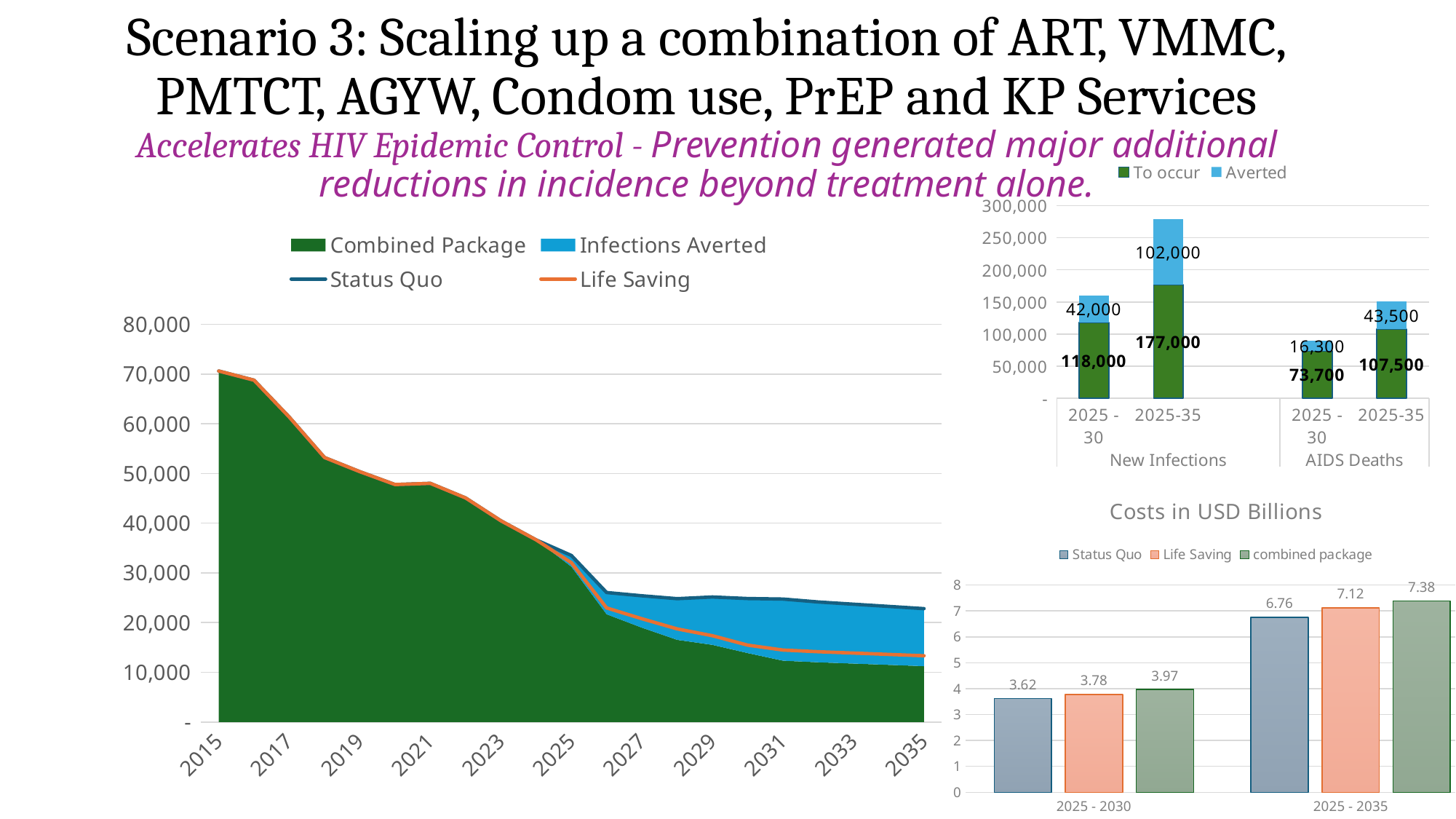
In the large chart on the left, is the Status Quo value in 2035 greater or less than 20,000? greater In the 'Costs in USD Billions' chart, what is the difference between the combined package and Status Quo values in 2025 - 2030? 0.35 In the top-right stacked bar chart, what is the total of the New Infections 2025-35 bar? 279,000 In the large chart on the left, how many series does the legend list? 4 In the 'Costs in USD Billions' chart, what is the value for the combined package in 2025 - 2035? 7.38 In the 'Costs in USD Billions' chart, which series has the highest value in 2025 - 2035? combined package In the top-right stacked bar chart, what is the 'To occur' value for New Infections in 2025-35? 177,000 In the 'Costs in USD Billions' chart, what is the value for Status Quo in 2025 - 2030? 3.62 In the large chart on the left, do the values generally rise or fall from 2015 to 2035? fall In the top-right stacked bar chart, which is larger: the 'Averted' value for New Infections 2025-35 or the 'Averted' value for AIDS Deaths 2025-35? New Infections 2025-35 In the 'Costs in USD Billions' chart, how many series does the legend list? 3 In the top-right stacked bar chart, what is the 'Averted' value for AIDS Deaths in 2025 - 30? 16,300